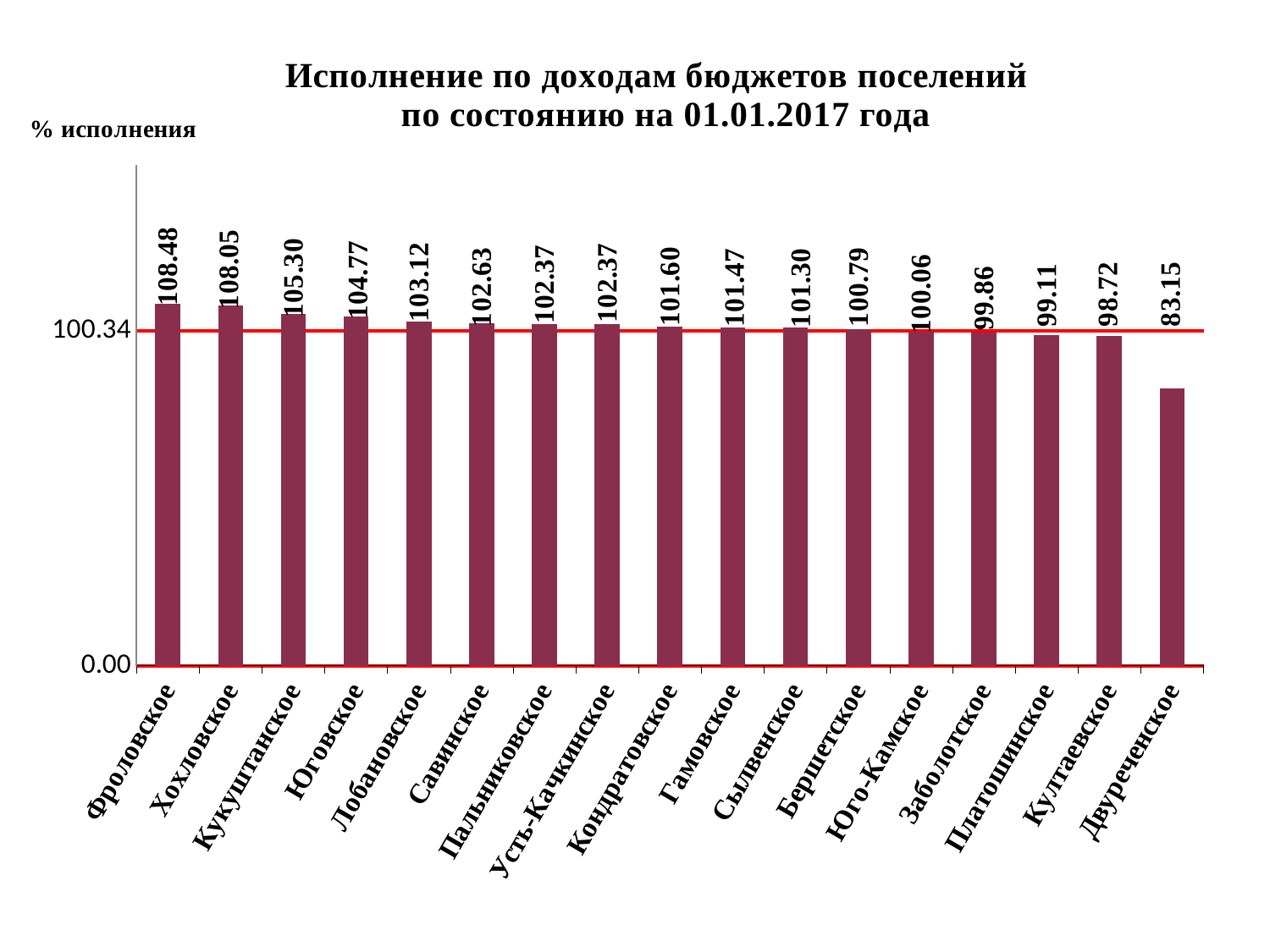
Which category has the highest value? Фроловское Which is larger, the value for Кукуштанское or the value for Юговское? Кукуштанское What is the value for Фроловское? 108.48 How many categories are shown on the x axis? 17 What is the difference between the values for Фроловское and Двуреченское? 25.33 Do the values rise or fall from left to right along the x axis? fall What is the title of the chart? Исполнение по доходам бюджетов поселений по состоянию на 01.01.2017 года What kind of chart is shown on the slide? bar chart What is the value for Юго-Камское? 100.06 Which category has the lowest value? Двуреченское What is the value for Двуреченское? 83.15 What value is marked by the horizontal red line on the chart? 100.34